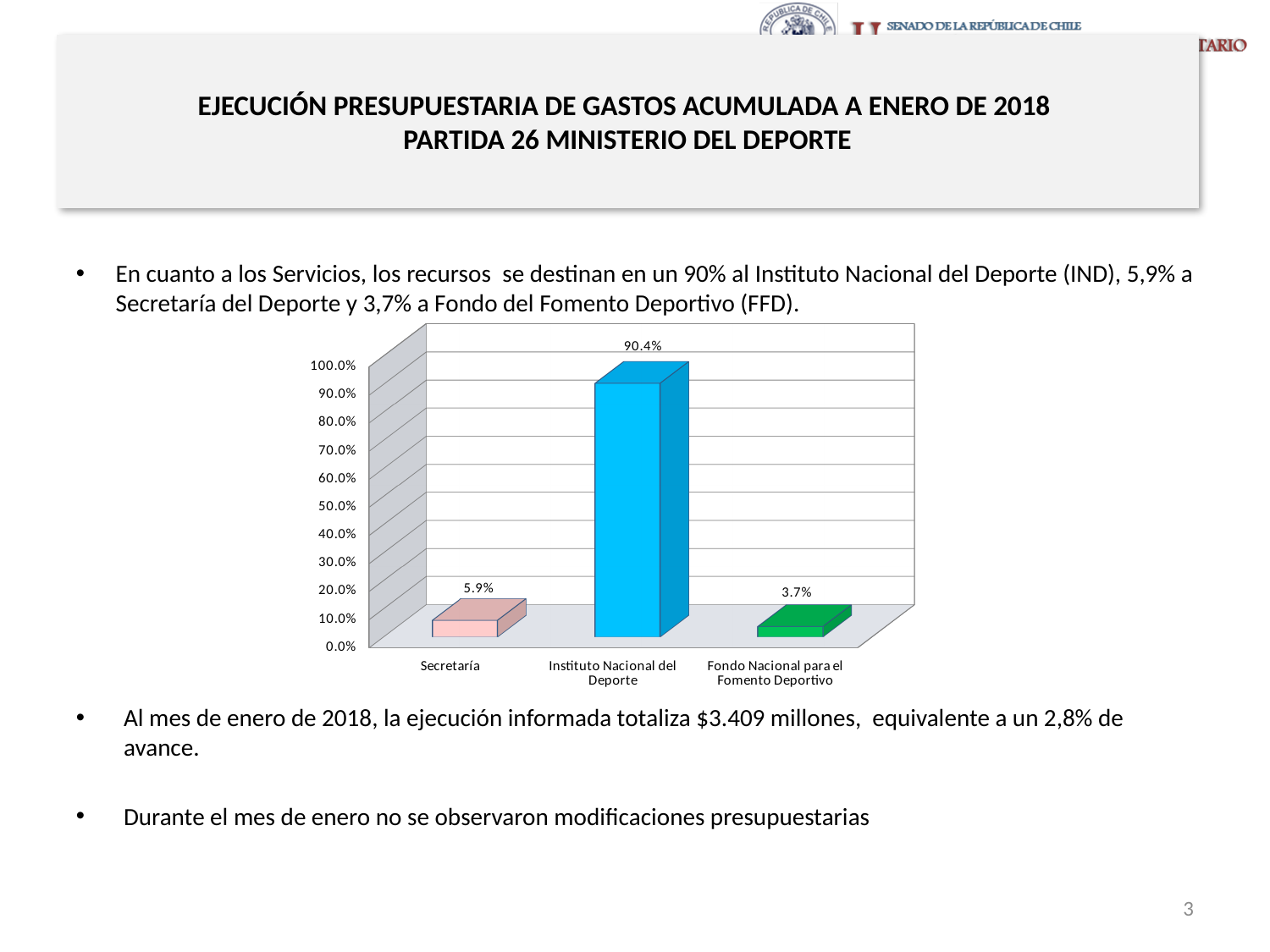
Is the value for Instituto Nacional del Deporte greater or less than 80.0%? greater What is the value for Fondo Nacional para el Fomento Deportivo? 3.7% What is the value for Instituto Nacional del Deporte? 90.4% How many categories are shown on the x axis of the chart? 3 What is the difference between the values for Instituto Nacional del Deporte and Secretaría? 84.5% What is the value for Secretaría? 5.9% What colour is the bar for Instituto Nacional del Deporte? blue Which is larger, the value for Secretaría or the value for Fondo Nacional para el Fomento Deportivo? Secretaría What kind of chart is shown on the slide? bar chart What is the difference between the values for Secretaría and Fondo Nacional para el Fomento Deportivo? 2.2% Which category has the lowest value? Fondo Nacional para el Fomento Deportivo Which category has the highest value? Instituto Nacional del Deporte